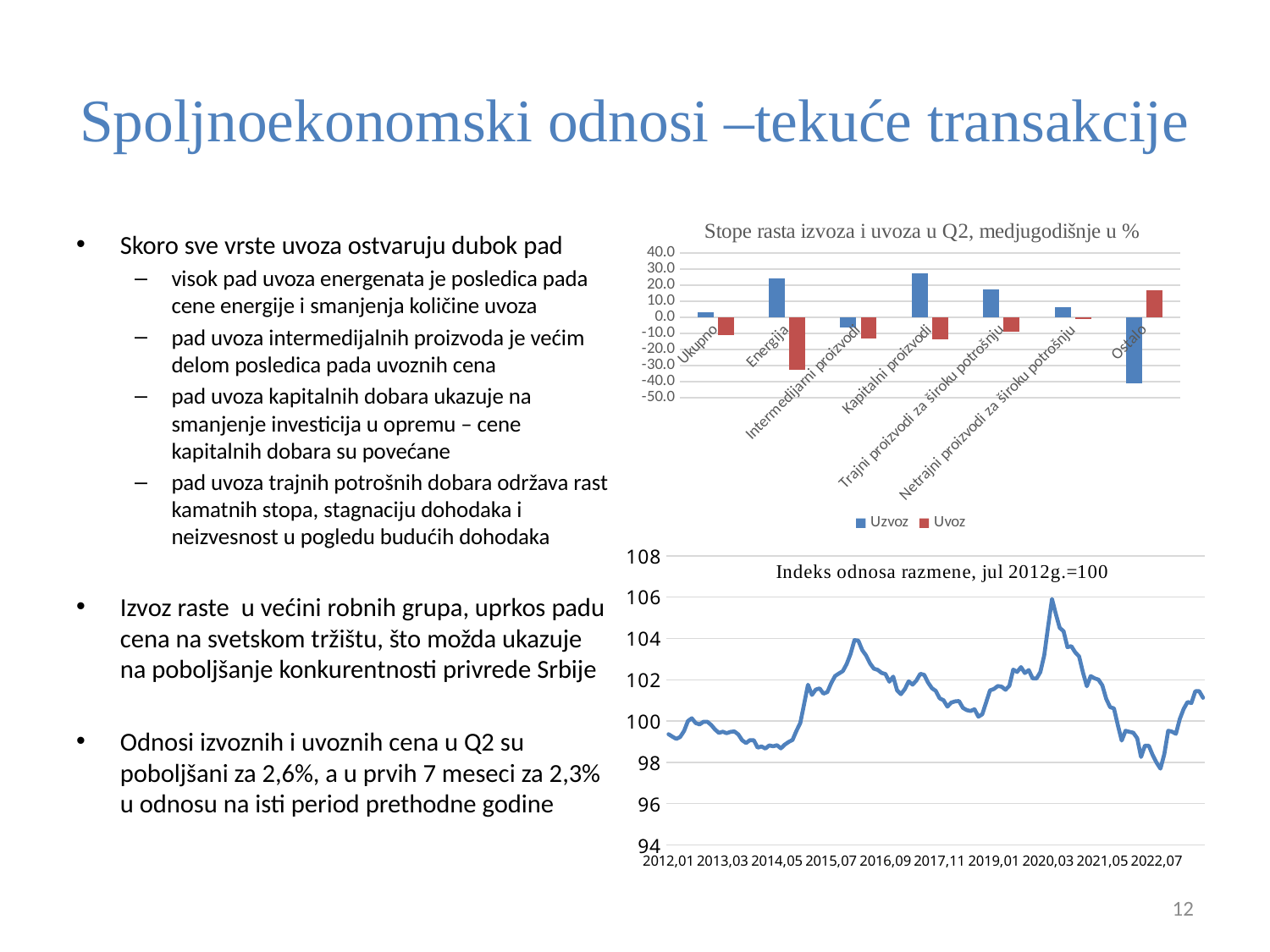
In the top bar chart, which category has the highest Uvoz value? Ostalo In the top bar chart, is the Uzvoz value for Kapitalni proizvodi greater or less than 20.0? greater In the top bar chart, what are the two legend entries? Uzvoz and Uvoz What kind of chart is the bottom chart titled "Indeks odnosa razmene, jul 2012g.=100"? line chart In the top bar chart, which category has the lowest Uzvoz value? Ostalo In the top bar chart, which category has the lowest Uvoz value? Energija In the bottom line chart, is the highest point of the index greater or less than 104? greater In the top bar chart, which is larger: the Uzvoz value for Energija or the Uzvoz value for Ukupno? Energija What kind of chart is the top chart titled "Stope rasta izvoza i uvoza u Q2, medjugodišnje u %"? bar chart In the top bar chart, how many categories are shown on the x axis? 7 In the top bar chart, how many series does the legend list? 2 In the top bar chart, is the Uvoz value for Energija greater or less than -30.0? less